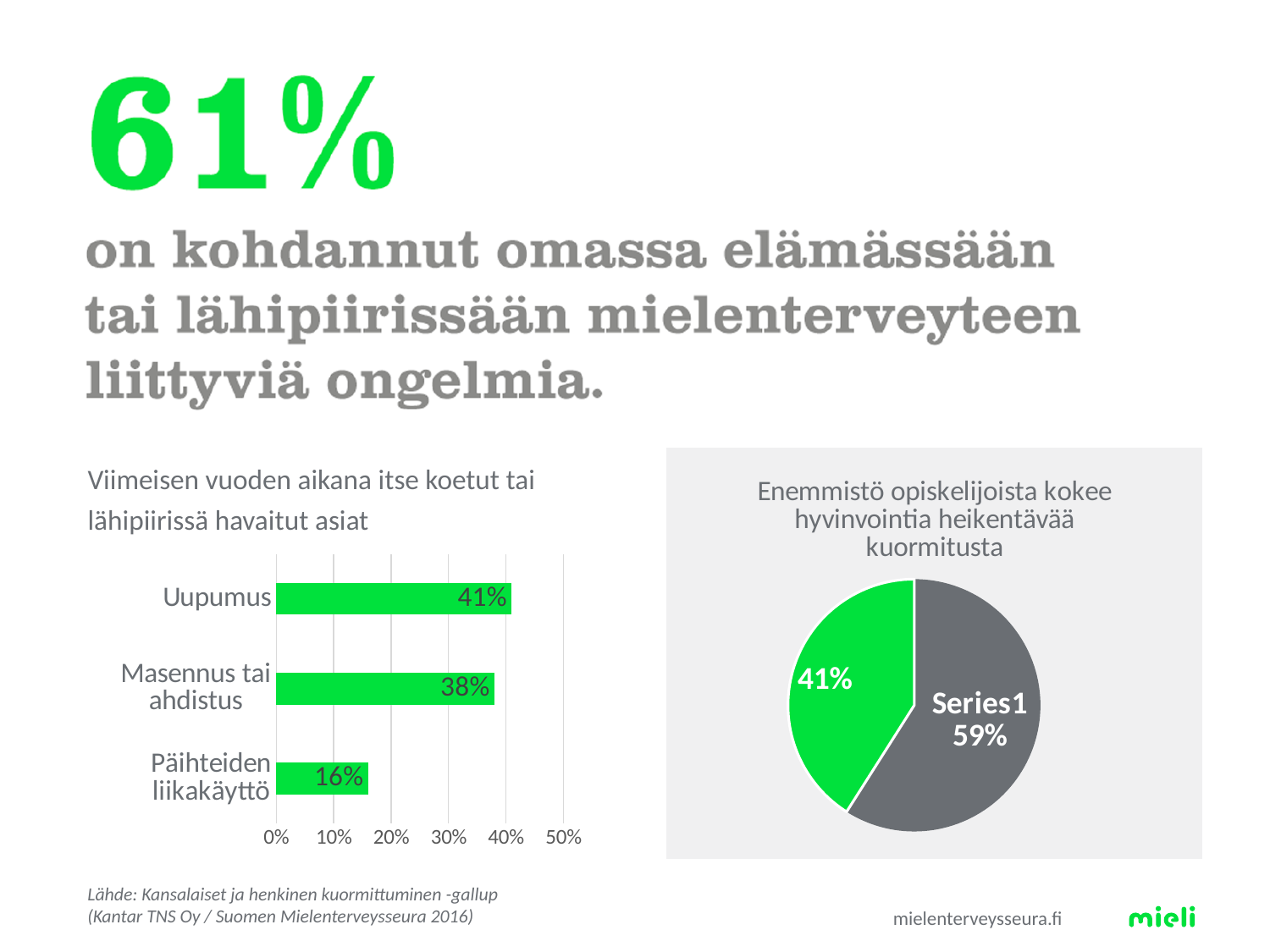
In the bar chart on the left, which is larger: the value for Masennus tai ahdistus or the value for Päihteiden liikakäyttö? Masennus tai ahdistus What is the title of the pie chart on the right? Enemmistö opiskelijoista kokee hyvinvointia heikentävää kuormitusta In the bar chart on the left, which category has the highest value? Uupumus In the pie chart on the right, what share is labelled Series1? 59% In the bar chart on the left, what is the value for Masennus tai ahdistus? 38% In the bar chart on the left, which category has the lowest value? Päihteiden liikakäyttö In the bar chart on the left, what is the value for Päihteiden liikakäyttö? 16% In the bar chart on the left, what is the difference between the values for Uupumus and Päihteiden liikakäyttö? 25% In the pie chart on the right, what is the value of the green slice? 41% In the bar chart on the left, how many categories are shown? 3 What kind of chart is the chart on the left of the slide? Bar chart In the bar chart on the left, what is the value for Uupumus? 41%